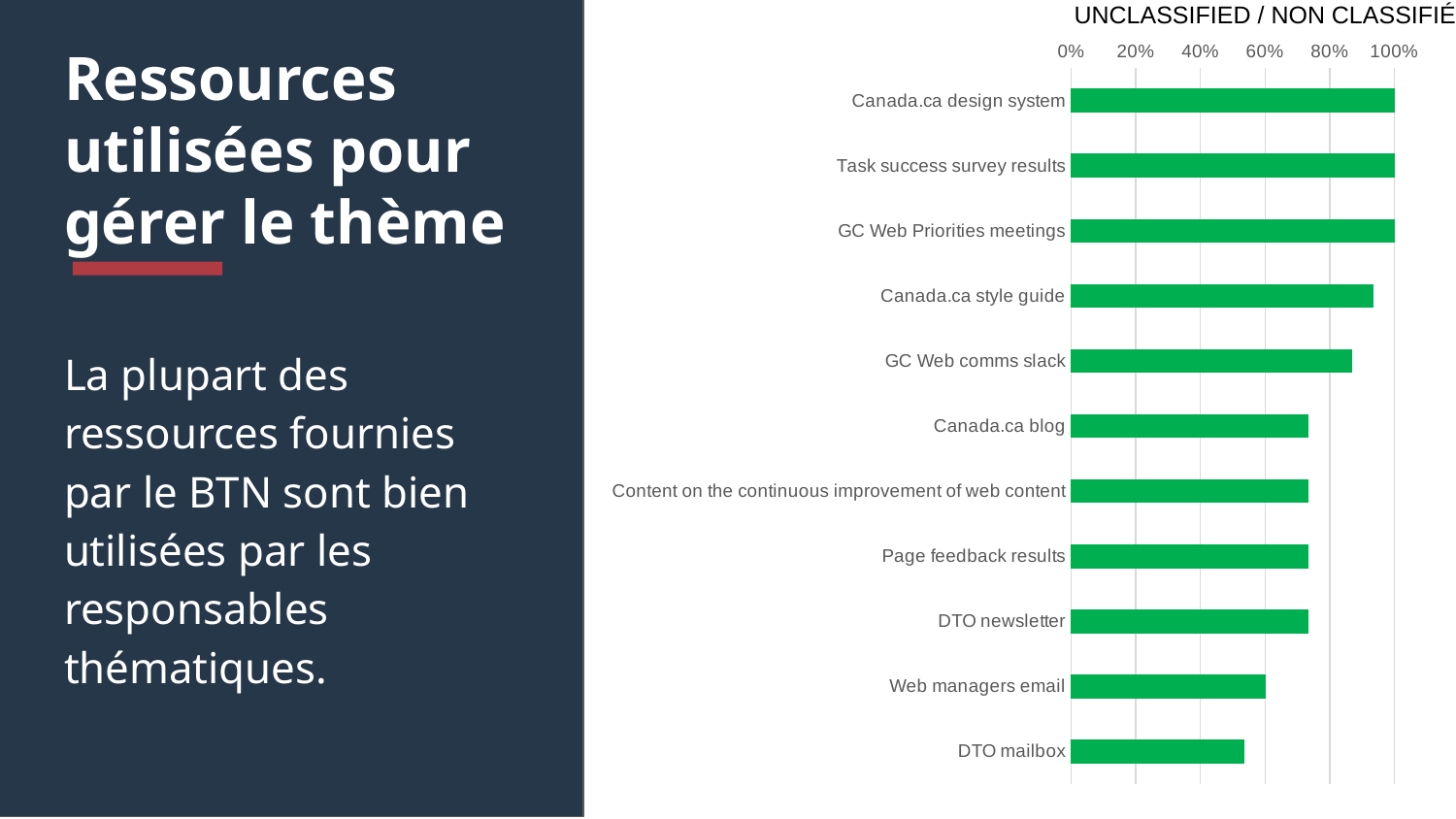
What kind of chart is shown on the slide? bar chart Is the value for DTO mailbox greater or less than 60%? less What is the value for Canada.ca design system? 100% Which is larger, the value for Canada.ca style guide or the value for GC Web comms slack? Canada.ca style guide Is the value for Canada.ca blog greater or less than 80%? less Is the value for Canada.ca style guide greater or less than 80%? greater Which resource has the lowest value in the chart? DTO mailbox What colour are the bars in the chart? green What is the value for GC Web Priorities meetings? 100% Which is larger, the value for Web managers email or the value for DTO mailbox? Web managers email How many categories (resources) are plotted in the chart? 11 What is the value for Web managers email? 60%